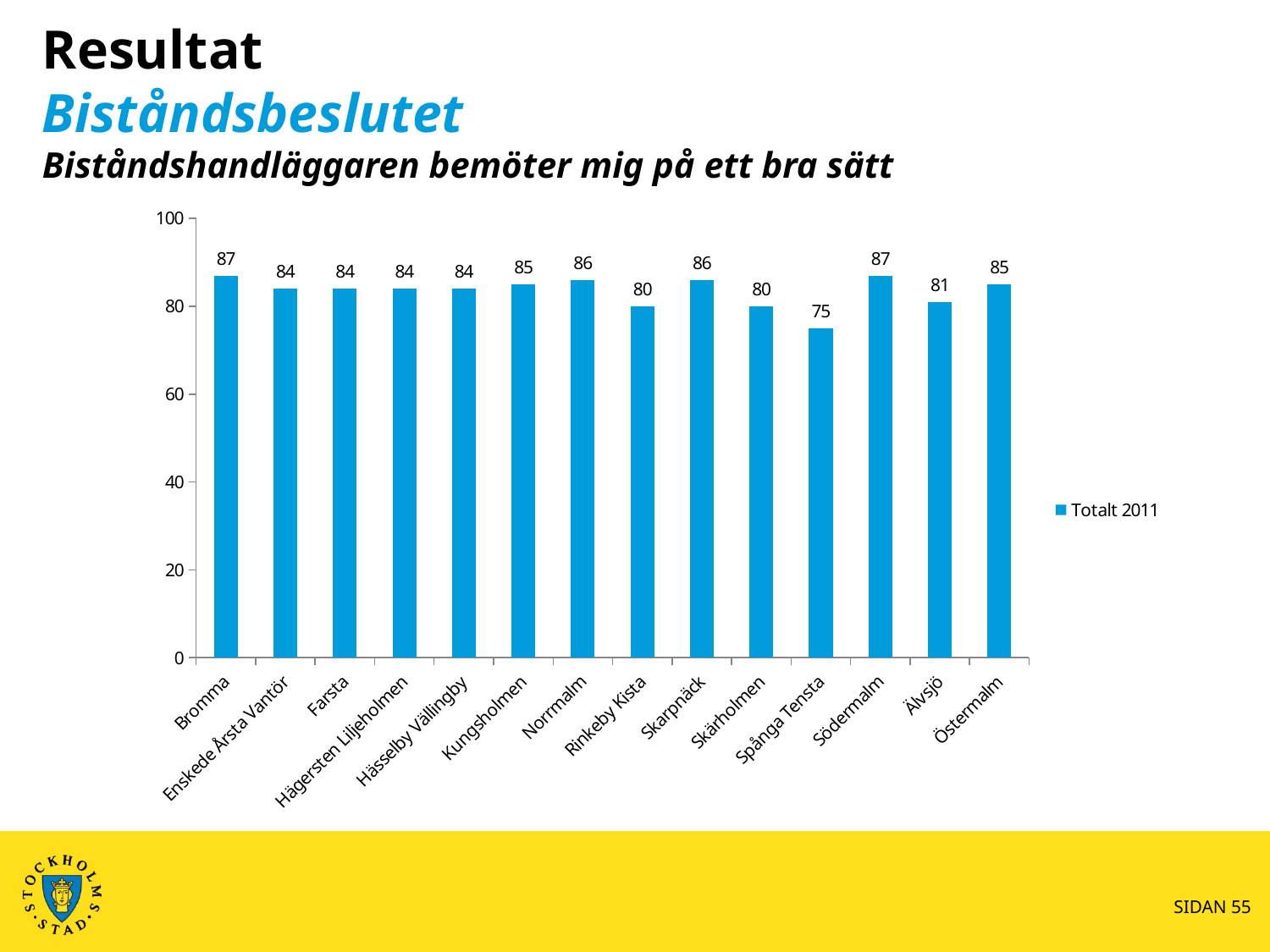
Is the value for Spånga Tensta greater or less than 80? less How many series does the legend list? 1 What is the value for Bromma? 87 What is the difference between the values for Kungsholmen and Rinkeby Kista? 5 What is the value for Älvsjö? 81 Which is larger, the value for Östermalm or the value for Skärholmen? Östermalm What is the value for Spånga Tensta? 75 What is the value for Norrmalm? 86 How many categories are shown on the x axis? 14 What is the difference between the values for Södermalm and Spånga Tensta? 12 Which category has the lowest value? Spånga Tensta What kind of chart is shown on the slide? bar chart